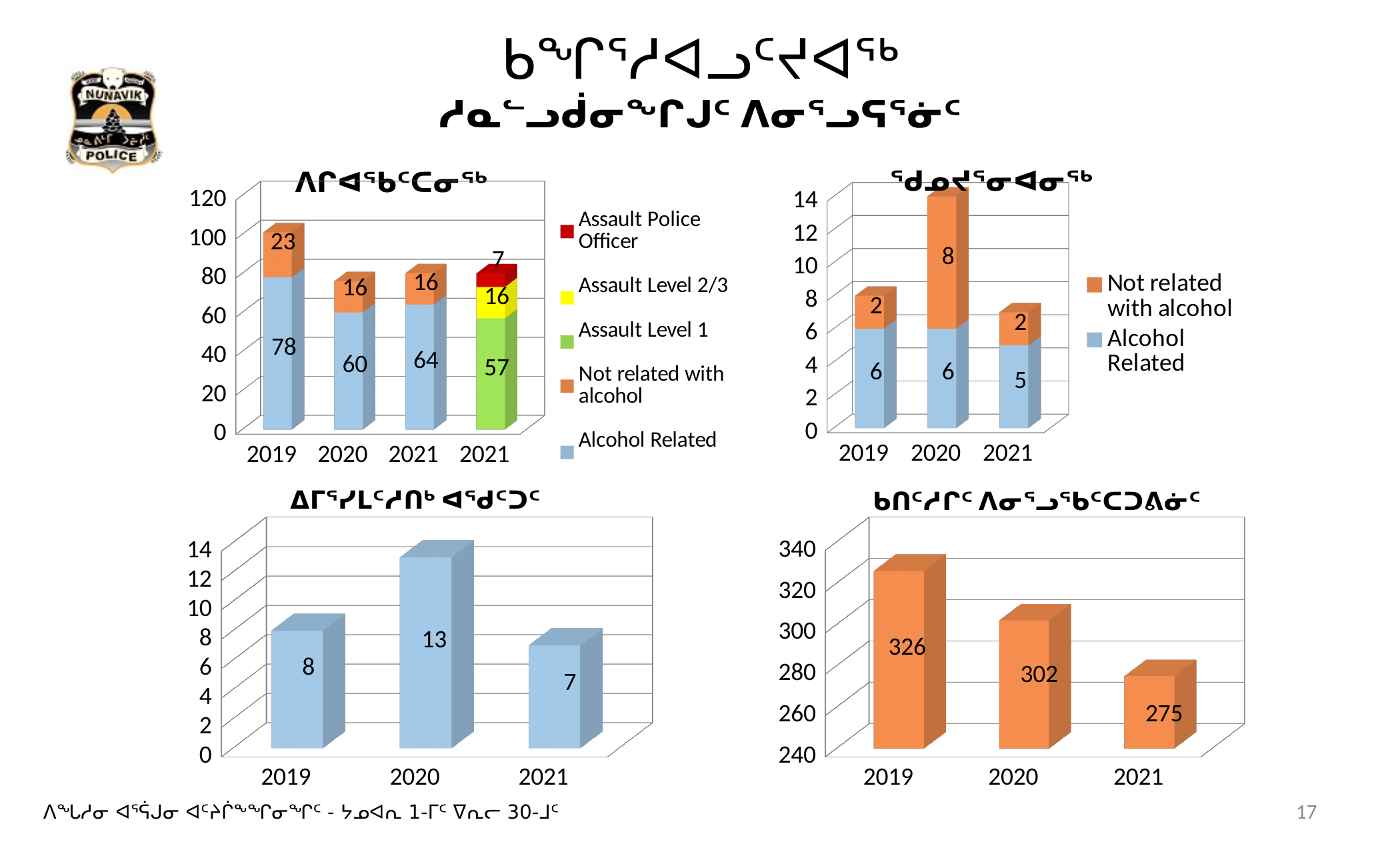
In the bottom-right chart, do the values rise or fall from 2019 to 2021? fall In the bottom-left chart, how many bars are plotted? 3 In the bottom-right chart, what is the difference between the 2019 and 2021 values? 51 In the bottom-right chart, which year has the lowest value? 2021 In the top-left chart, what is the 'Alcohol Related' value for 2019? 78 In the bottom-left chart, which year has the highest value? 2020 In the top-left chart, what is the total of the stacked bar for 2019? 101 In the bottom-right chart, what is the value for 2019? 326 In the bottom-left chart, what is the value for 2020? 13 In the top-right chart, what is the 'Not related with alcohol' value for 2020? 8 In the top-right chart, what is the total of the stacked bar for 2020? 14 In the top-left chart, how many series does the legend list? 5